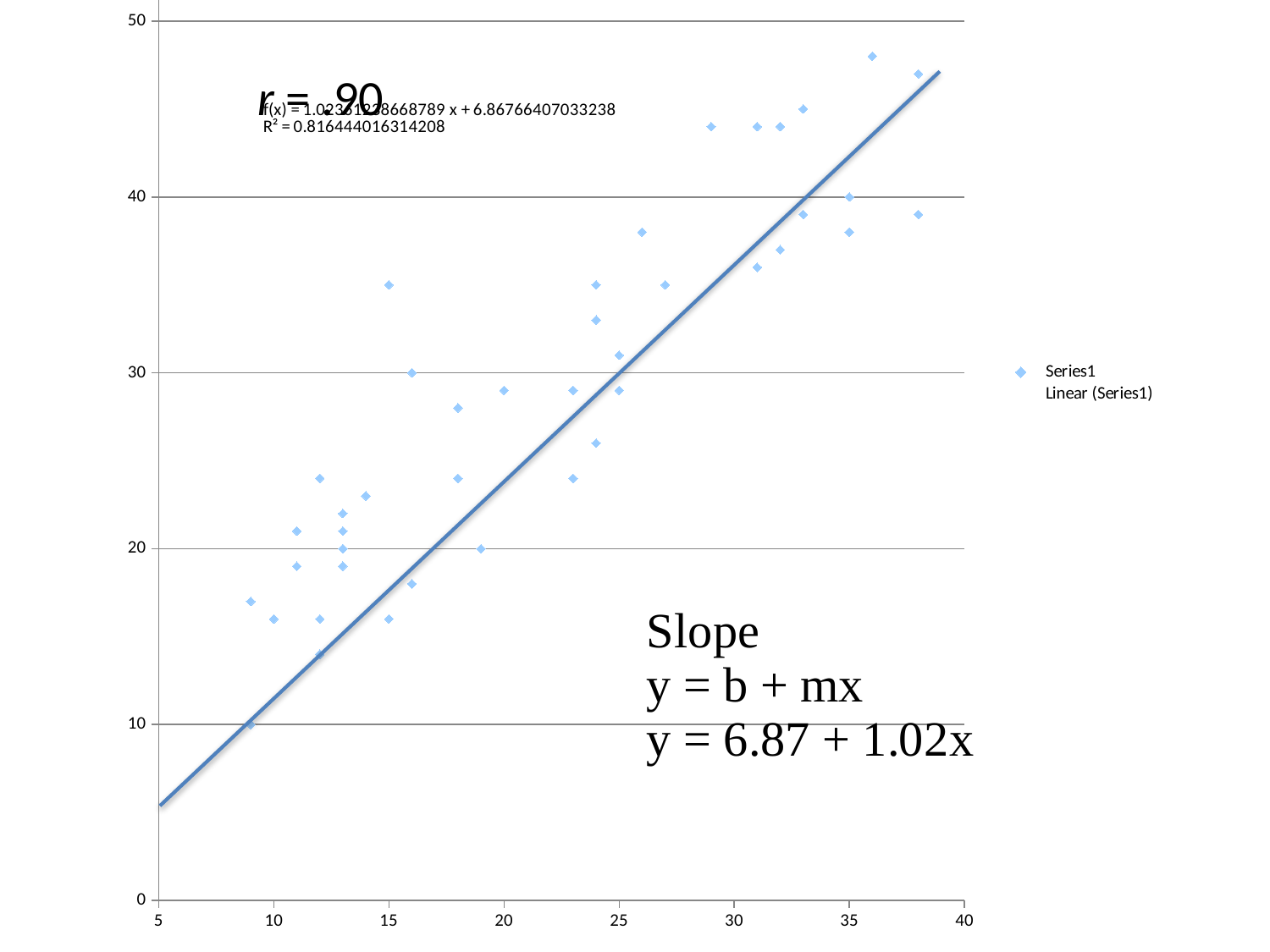
Is the point plotted at x = 26 greater or less than 30 on the y axis? greater How many entries does the legend list? 2 What R² value is printed on the chart? R² = 0.816444016314208 What are the two entries listed in the legend? Series1 and Linear (Series1) What kind of chart is shown on the slide? Scatter chart Is the lowest plotted point on the chart greater or less than 20 on the y axis? less What is the highest value shown on the y axis? 50 Is the highest point plotted at x = 15 greater or less than 30 on the y axis? greater Do the plotted values generally rise or fall as x increases? Rise